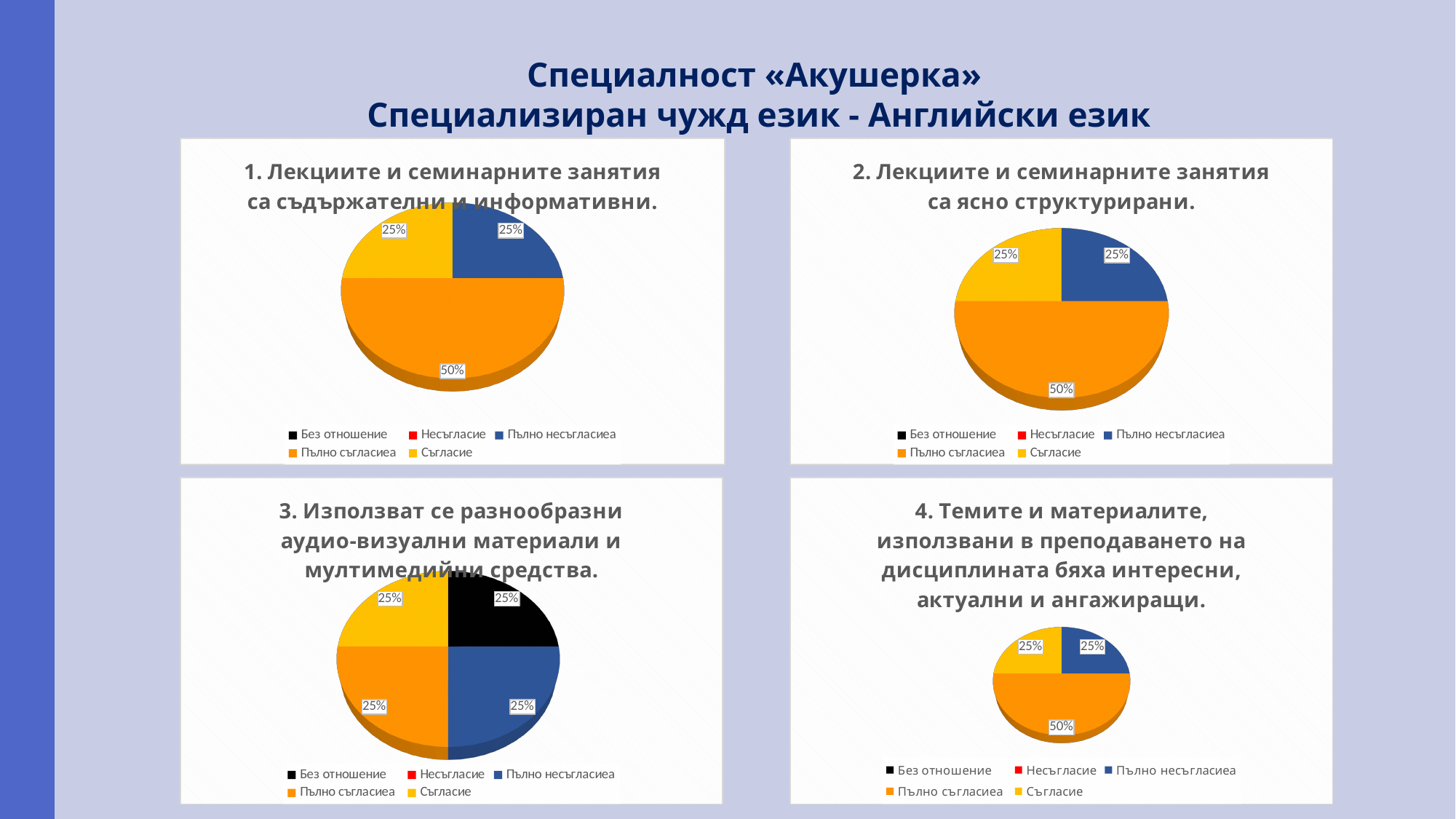
In the top-left chart (1. Лекциите и семинарните занятия са съдържателни и информативни), which is larger: the Пълно съгласиеа slice or the Пълно несъгласиеа slice? Пълно съгласиеа In the top-right chart (2. Лекциите и семинарните занятия са ясно структурирани), what share does the Пълно несъгласиеа slice have? 25% In the top-left chart (1. Лекциите и семинарните занятия са съдържателни и информативни), what share does the Пълно съгласиеа slice have? 50% In the top-left chart (1. Лекциите и семинарните занятия са съдържателни и информативни), what share does the Съгласие slice have? 25% In the top-right chart (2. Лекциите и семинарните занятия са ясно структурирани), which category has the largest slice? Пълно съгласиеа What type of chart is used in the top-right chart (2. Лекциите и семинарните занятия са ясно структурирани)? Pie chart In the bottom-right chart (4. Темите и материалите, използвани в преподаването на дисциплината бяха интересни, актуални и ангажиращи), what share does the Пълно съгласиеа slice have? 50% In the bottom-left chart (3. Използват се разнообразни аудио-визуални материали и мултимедийни средства), how many slices does the pie have? 4 In the top-left chart (1. Лекциите и семинарните занятия са съдържателни и информативни), what colour is the Пълно съгласиеа slice? Orange How many entries does the legend of the bottom-left chart (3. Използват се разнообразни аудио-визуални материали и мултимедийни средства) list? 5 In the bottom-right chart (4. Темите и материалите...), what is the difference between the Пълно съгласиеа share and the Съгласие share? 25% In the bottom-left chart (3. Използват се разнообразни аудио-визуални материали и мултимедийни средства), what share does the Без отношение slice have? 25%